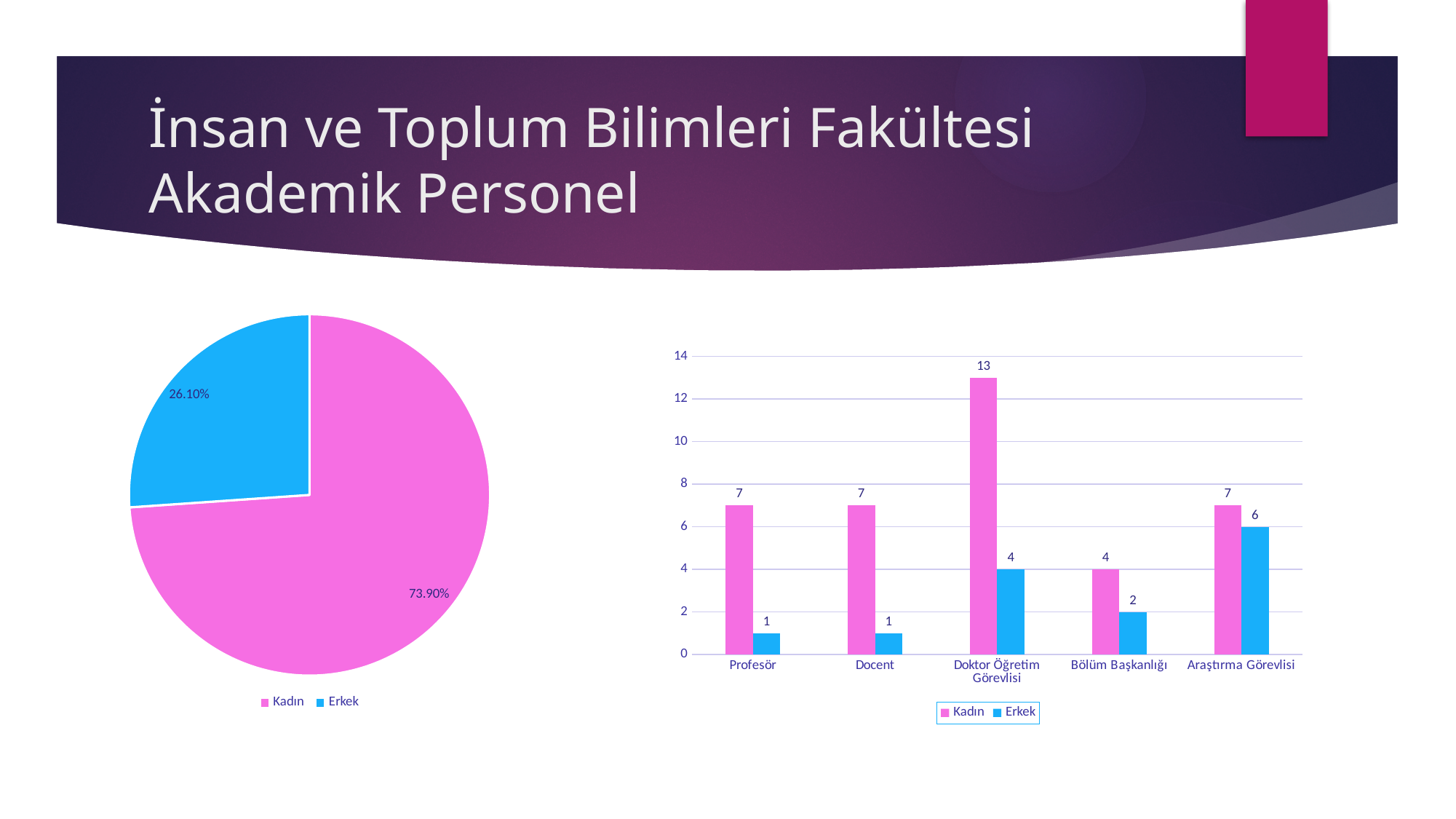
In the bar chart on the right, which category has the highest Kadın value? Doktor Öğretim Görevlisi In the bar chart on the right, is the Kadın value for Bölüm Başkanlığı larger or smaller than the Erkek value for Bölüm Başkanlığı? larger In the bar chart on the right, what is the Erkek value for Araştırma Görevlisi? 6 In the pie chart on the left, what share does Kadın have? 73.90% In the bar chart on the right, how many categories are shown on the x axis? 5 In the pie chart on the left, what share does Erkek have? 26.10% In the bar chart on the right, which category has the lowest Erkek value? Profesör and Docent In the bar chart on the right, what is the difference between the Kadın and Erkek values for Doktor Öğretim Görevlisi? 9 In the pie chart on the left, which slice is larger, Kadın or Erkek? Kadın In the bar chart on the right, how many series does the legend list? 2 What kind of chart is the chart on the right? bar chart In the bar chart on the right, what is the Kadın value for Doktor Öğretim Görevlisi? 13